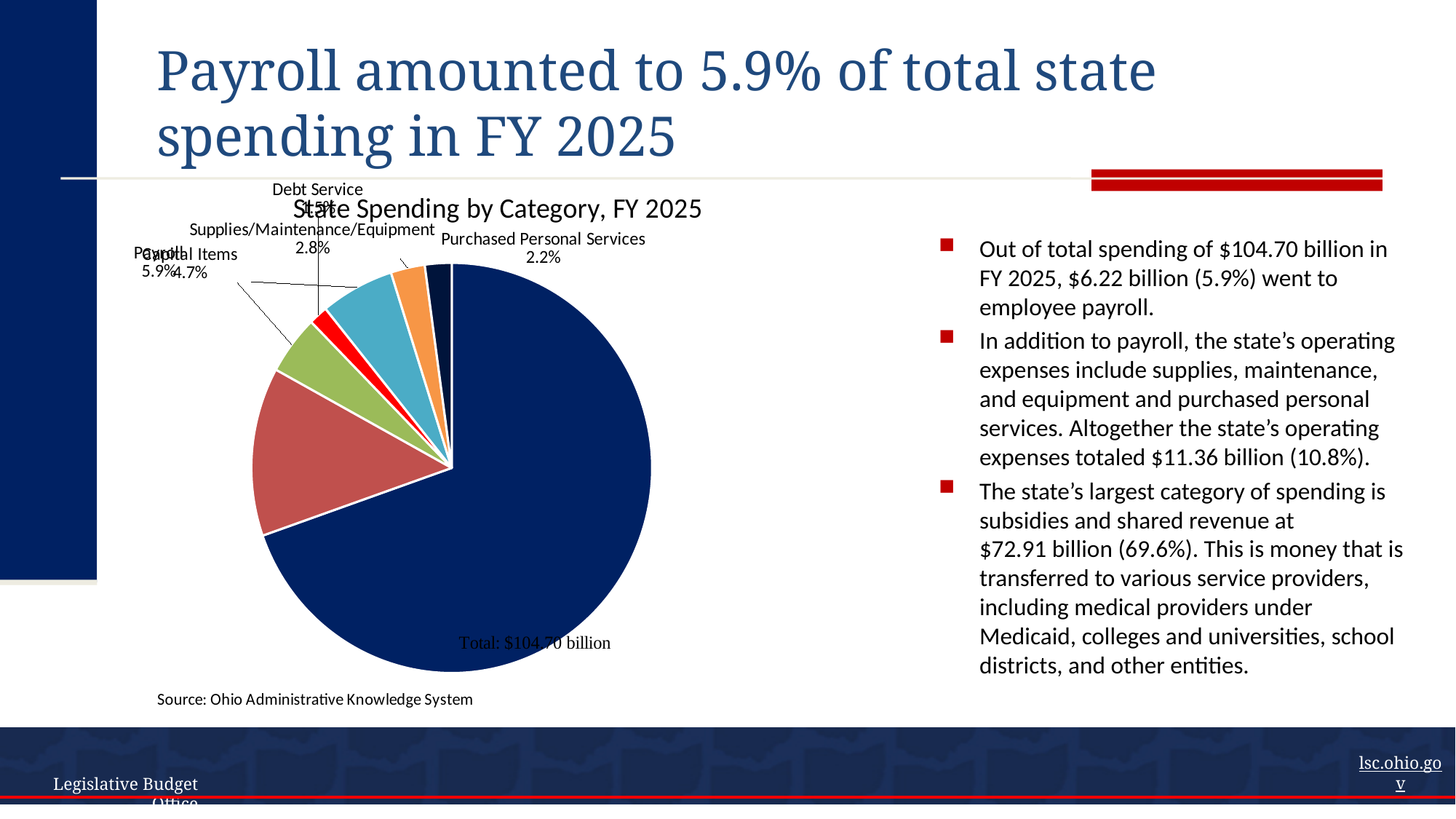
By how many percentage points does the Payroll share exceed the Purchased Personal Services share? 3.7 What share of state spending does the chart show for Purchased Personal Services? 2.2% How many slices does the pie chart have? 7 By how many percentage points does the Capital Items share exceed the Supplies/Maintenance/Equipment share? 1.9 What share of state spending does the chart show for Capital Items? 4.7% Which has the larger share in the chart, Supplies/Maintenance/Equipment or Purchased Personal Services? Supplies/Maintenance/Equipment What total spending amount is printed on the chart? Total: $104.70 billion What is the title of the chart? State Spending by Category, FY 2025 What share of state spending does the chart show for Payroll? 5.9% Which has the larger share in the chart, Payroll or Capital Items? Payroll What share of state spending does the chart show for Supplies/Maintenance/Equipment? 2.8% What kind of chart is shown on the slide? pie chart